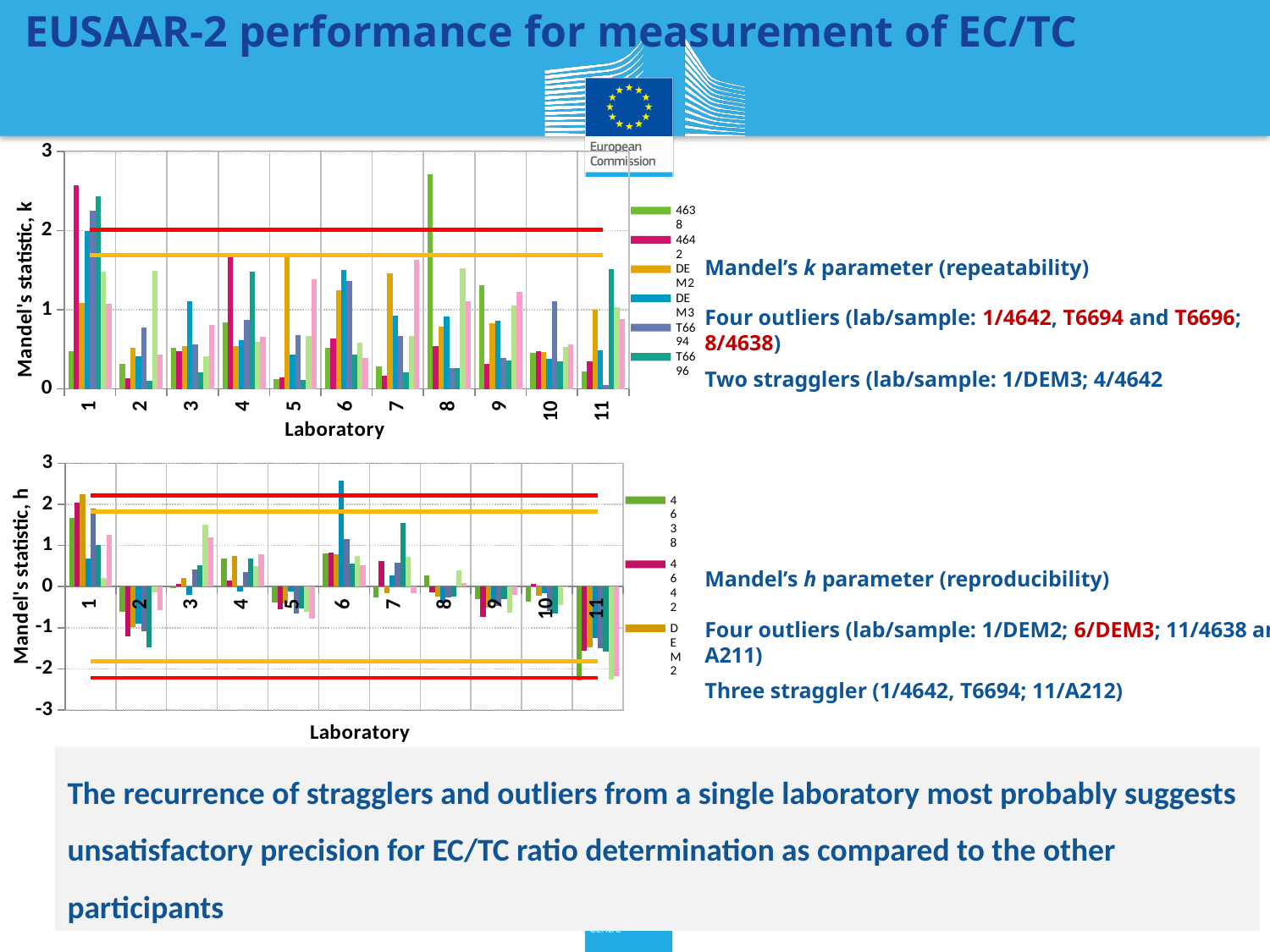
What is the x-axis title of the top chart (Mandel's statistic, k)? Laboratory In the top chart (Mandel's statistic, k), is the tallest bar for laboratory 8 greater or less than 2? greater What kind of chart is the top chart (Mandel's statistic, k)? bar chart In the bottom chart (Mandel's statistic, h), is the lowest bar for laboratory 11 greater or less than -1? less In the bottom chart (Mandel's statistic, h), which laboratory has the lowest (most negative) bar? 11 What is the y-axis title of the bottom chart? Mandel's statistic, h What kind of chart is the bottom chart (Mandel's statistic, h)? bar chart In the top chart (Mandel's statistic, k), how many laboratories are shown on the x axis? 11 In the bottom chart (Mandel's statistic, h), how many laboratories are shown on the x axis? 11 In the top chart (Mandel's statistic, k), is the tallest bar for laboratory 3 greater or less than 2? less